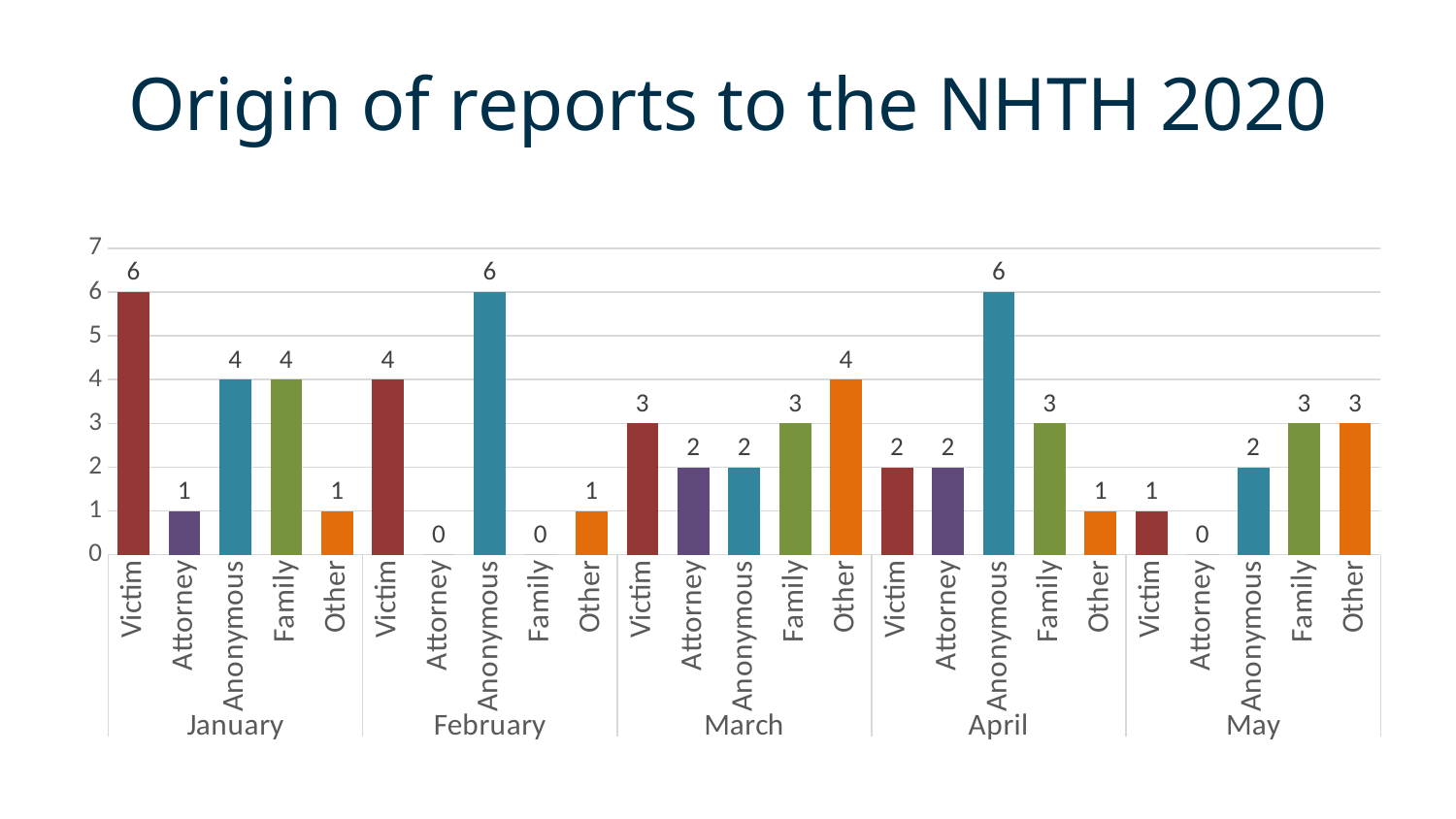
What is the difference between Victim in January and Victim in May? 5 What is the value for Other in March? 4 What is the value for Attorney in May? 0 What is the title of the chart? Origin of reports to the NHTH 2020 How many months are shown on the x axis? 5 What kind of chart is shown on the slide? Bar chart Which is larger, Family in March or Other in March? Other in March What is the value for Anonymous in February? 6 Which origin has the lowest value in February? Attorney and Family Do the values for Victim rise or fall from January to May? Fall Which origin has the highest value in April? Anonymous What is the value for Victim in January? 6